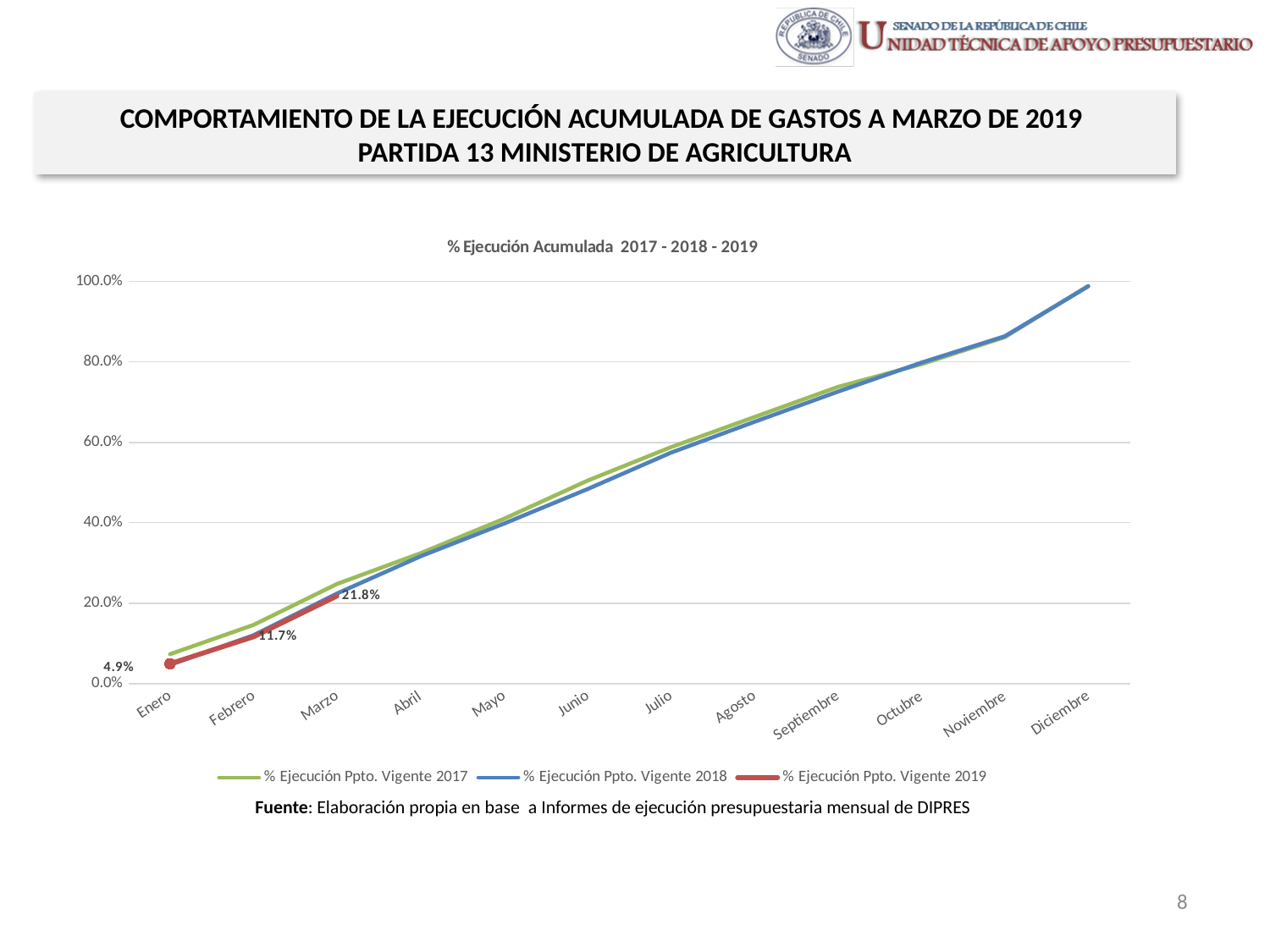
How many series does the legend list? 3 What is the title of the chart? % Ejecución Acumulada 2017 - 2018 - 2019 What kind of chart is shown on the slide? Line chart What is the value of % Ejecución Ppto. Vigente 2019 for Enero? 4.9% Which month has the highest value for the % Ejecución Ppto. Vigente 2019 series? Marzo What is the value of % Ejecución Ppto. Vigente 2019 for Marzo? 21.8% How many months are shown on the x axis? 12 Do the values of the % Ejecución Ppto. Vigente 2018 series rise or fall from Enero to Diciembre? Rise Is the value for % Ejecución Ppto. Vigente 2018 in Diciembre greater or less than 80.0%? greater What is the difference between the 2019 values for Marzo and Febrero? 10.1% What is the value of % Ejecución Ppto. Vigente 2019 for Febrero? 11.7% What is the difference between the 2019 values for Febrero and Enero? 6.8%